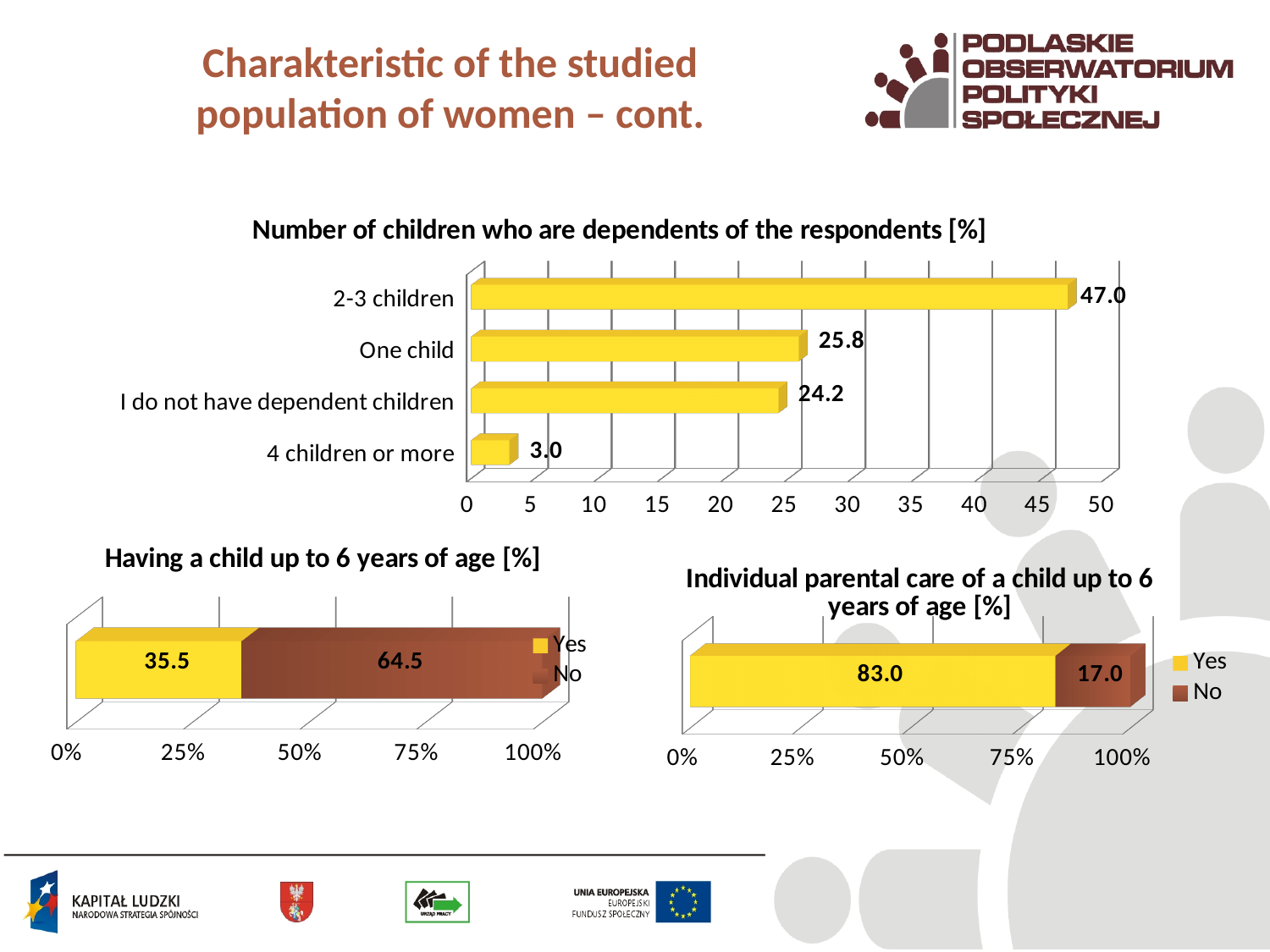
What kind of chart is 'Number of children who are dependents of the respondents [%]'? Bar chart In the chart 'Individual parental care of a child up to 6 years of age [%]', what is the difference between 'Yes' and 'No'? 66.0 In the chart 'Number of children who are dependents of the respondents [%]', which category has the lowest value? 4 children or more In the chart 'Number of children who are dependents of the respondents [%]', what is the difference between the values for '2-3 children' and 'One child'? 21.2 In the chart 'Number of children who are dependents of the respondents [%]', how many categories are shown? 4 In the chart 'Number of children who are dependents of the respondents [%]', what is the value for '2-3 children'? 47.0 In the chart 'Number of children who are dependents of the respondents [%]', which category has the highest value? 2-3 children In the chart 'Having a child up to 6 years of age [%]', which is larger, 'Yes' or 'No'? No In the chart 'Having a child up to 6 years of age [%]', what is the value for 'Yes'? 35.5 In the chart 'Individual parental care of a child up to 6 years of age [%]', what is the value for 'No'? 17.0 In the chart 'Number of children who are dependents of the respondents [%]', what is the value for 'I do not have dependent children'? 24.2 How many series does the legend of the chart 'Individual parental care of a child up to 6 years of age [%]' list? 2